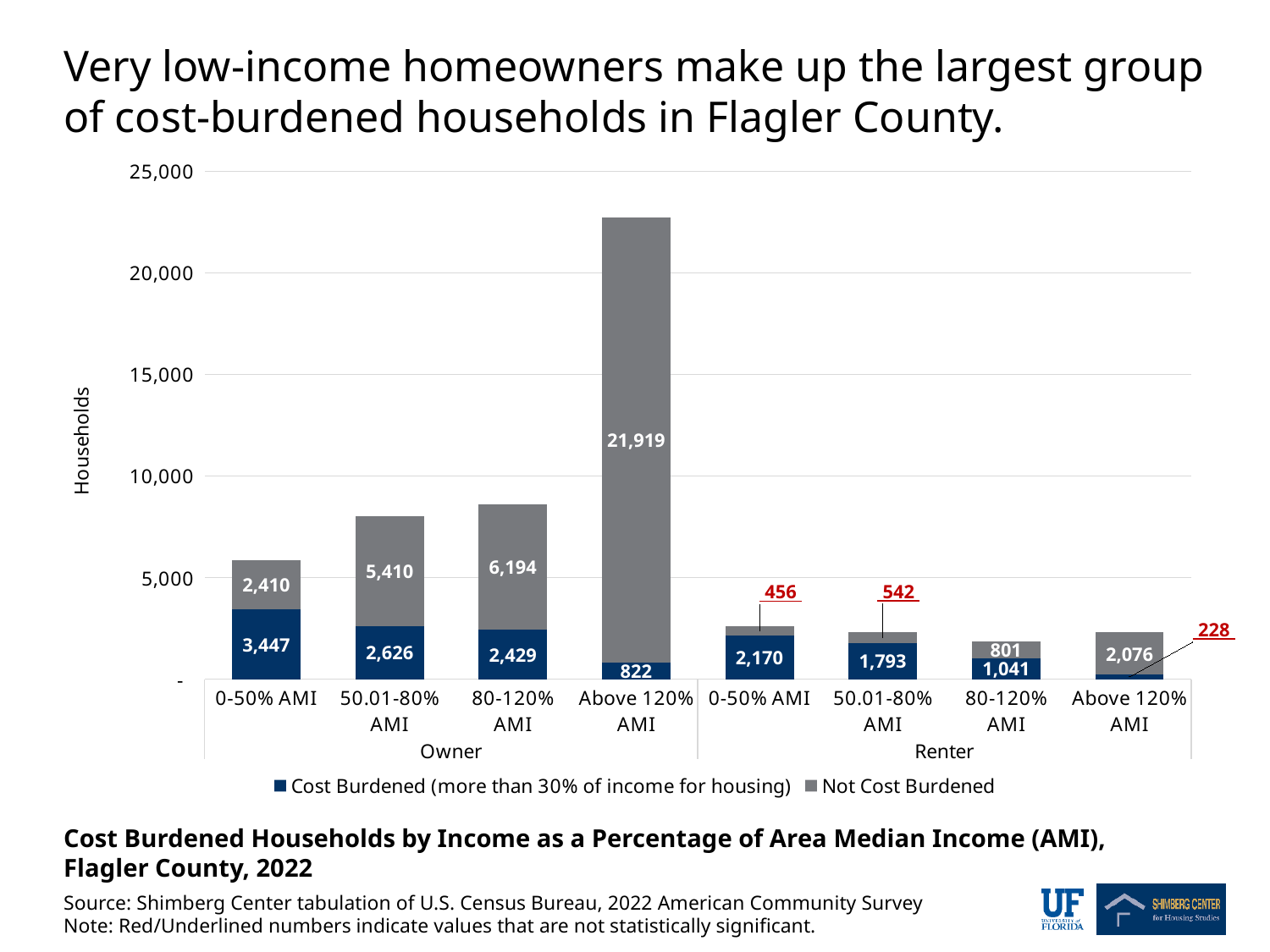
How many cost-burdened renter households are in the 50.01-80% AMI group? 1,793 How many cost-burdened owner households are in the 0-50% AMI group? 3,447 What is the difference between cost-burdened owner households at 0-50% AMI and cost-burdened renter households at 0-50% AMI? 1,277 What is the total number of owner households above 120% AMI (cost burdened plus not cost burdened)? 22,741 What is the number of not cost-burdened owner households above 120% AMI? 21,919 What is the not cost-burdened value for renters above 120% AMI? 2,076 Which income group has the highest number of cost-burdened households? Owner 0-50% AMI Which group has the lowest number of not cost-burdened households? Renter 0-50% AMI How many income categories are shown across the owner and renter groups combined? 8 What type of chart is shown on the slide? Stacked bar chart Which is larger: the number of cost-burdened owners at 50.01-80% AMI or cost-burdened owners at 80-120% AMI? Owners at 50.01-80% AMI How many series does the legend list? 2